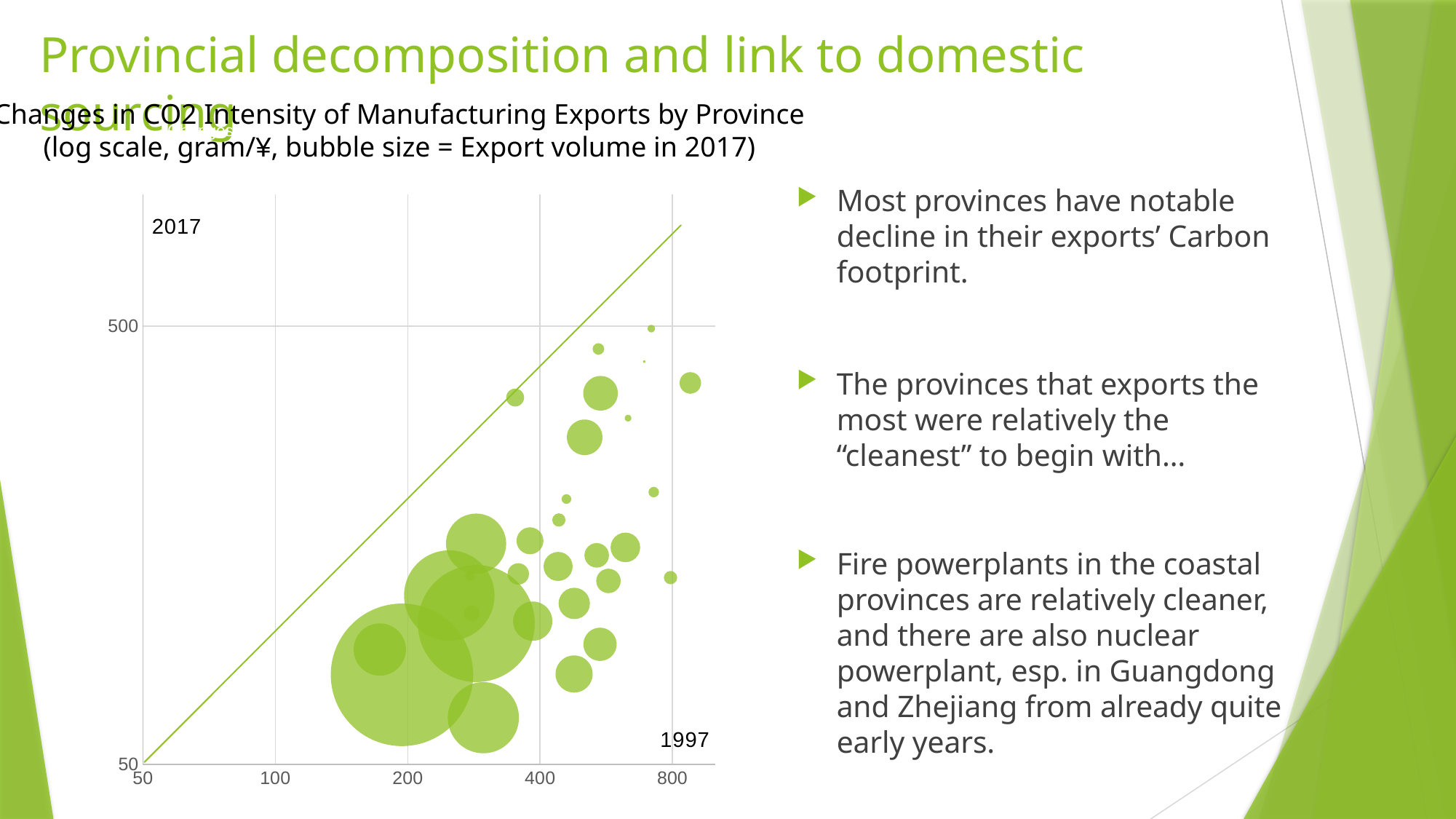
What is the lowest tick label shown on the y axis of the chart? 50 What is the title of the chart on the slide? Changes in CO2 Intensity of Manufacturing Exports by Province What kind of chart is shown on the slide? Bubble chart What is the highest tick label shown on the x axis of the chart? 800 How many tick labels are shown on the x axis of the chart? 5 According to the chart subtitle, what does the bubble size represent? Export volume in 2017 Which year is labelled on the horizontal axis of the chart? 1997 Which year is labelled on the vertical axis of the chart? 2017 What unit is given for the CO2 intensity in the chart subtitle? gram/¥